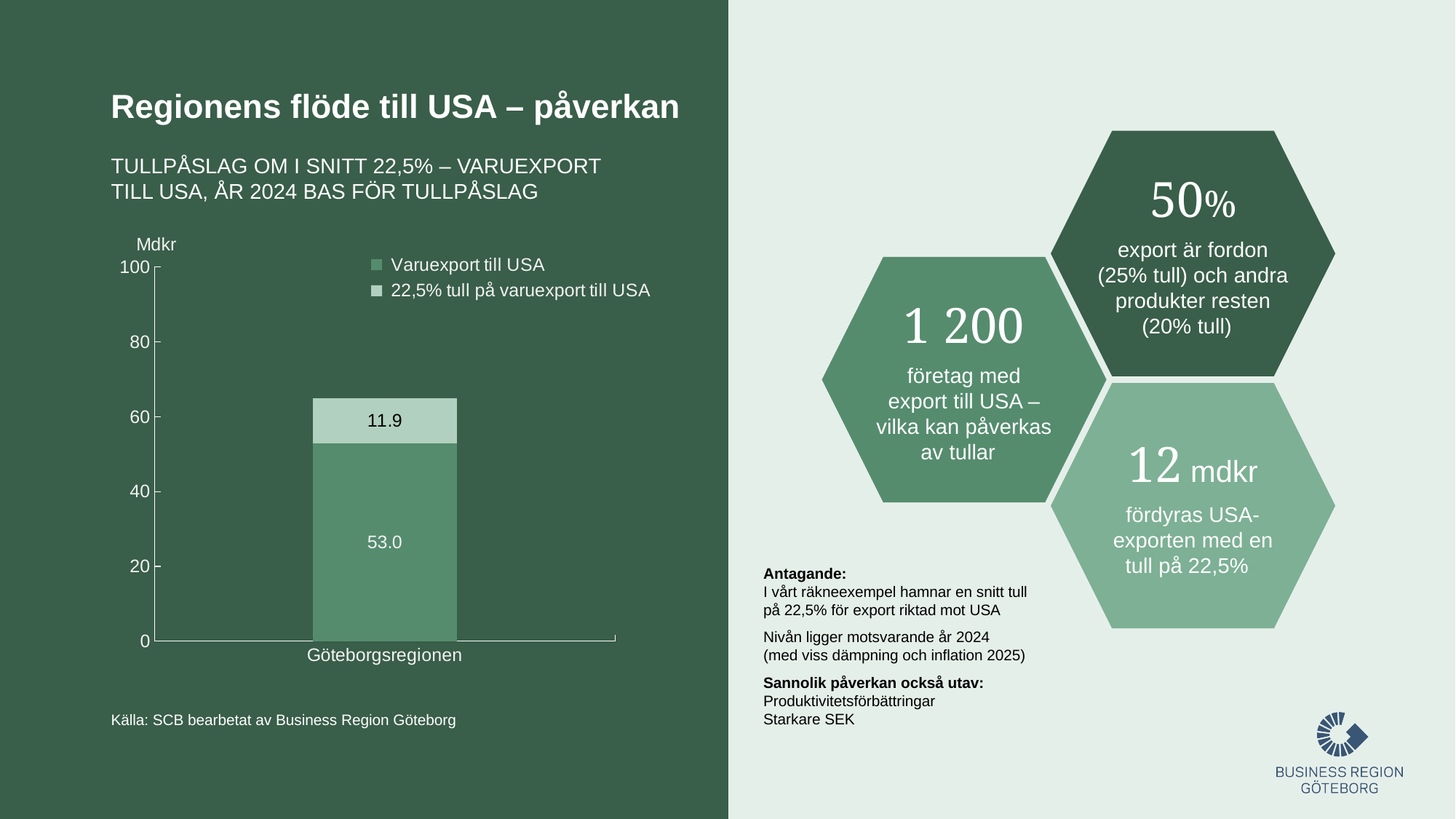
What is the label of the single category on the x axis? Göteborgsregionen What unit is shown at the top of the chart's y axis? Mdkr How many series does the chart legend list? 2 How many categories are shown on the x axis of the chart? 1 Is the total of the stacked bar for Göteborgsregionen greater or less than 60? greater What kind of chart is shown on the slide? Stacked bar chart Which segment is larger for Göteborgsregionen: 'Varuexport till USA' or '22,5% tull på varuexport till USA'? Varuexport till USA What is the value of the 'Varuexport till USA' segment for Göteborgsregionen? 53.0 Is the 'Varuexport till USA' segment greater or less than 40? greater What is the difference between the 'Varuexport till USA' segment and the '22,5% tull på varuexport till USA' segment? 41.1 What is the value of the '22,5% tull på varuexport till USA' segment for Göteborgsregionen? 11.9 What is the total height of the stacked bar for Göteborgsregionen? 64.9